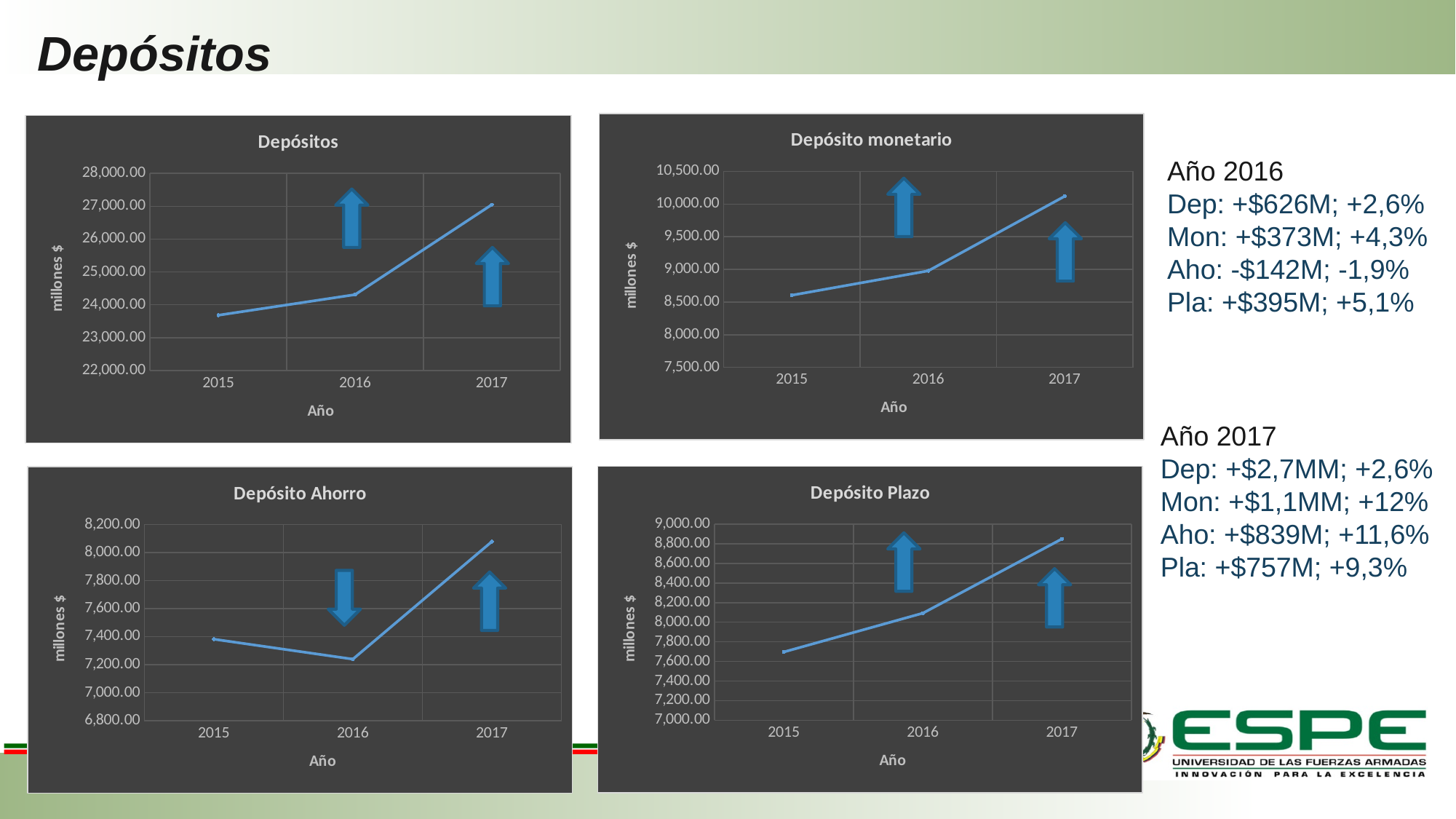
In the "Depósito Ahorro" chart, which year has the lowest value? 2016 In the "Depósito Plazo" chart, is the value for 2015 greater or less than 8,000.00? less In the "Depósito Plazo" chart, which year has the highest value? 2017 What is the label on the vertical axis of the "Depósito Plazo" chart? millones $ In the "Depósito monetario" chart, is the value for 2015 greater or less than 9,000.00? less In the "Depósitos" chart, do the values rise or fall from 2015 to 2017? Rise How many years are plotted on the "Depósito monetario" chart? 3 In the "Depósitos" chart, is the value for 2015 greater or less than 24,000.00? less What kind of chart is the "Depósitos" chart at the top left? Line chart In the "Depósito Ahorro" chart, which is larger, the value for 2015 or the value for 2016? 2015